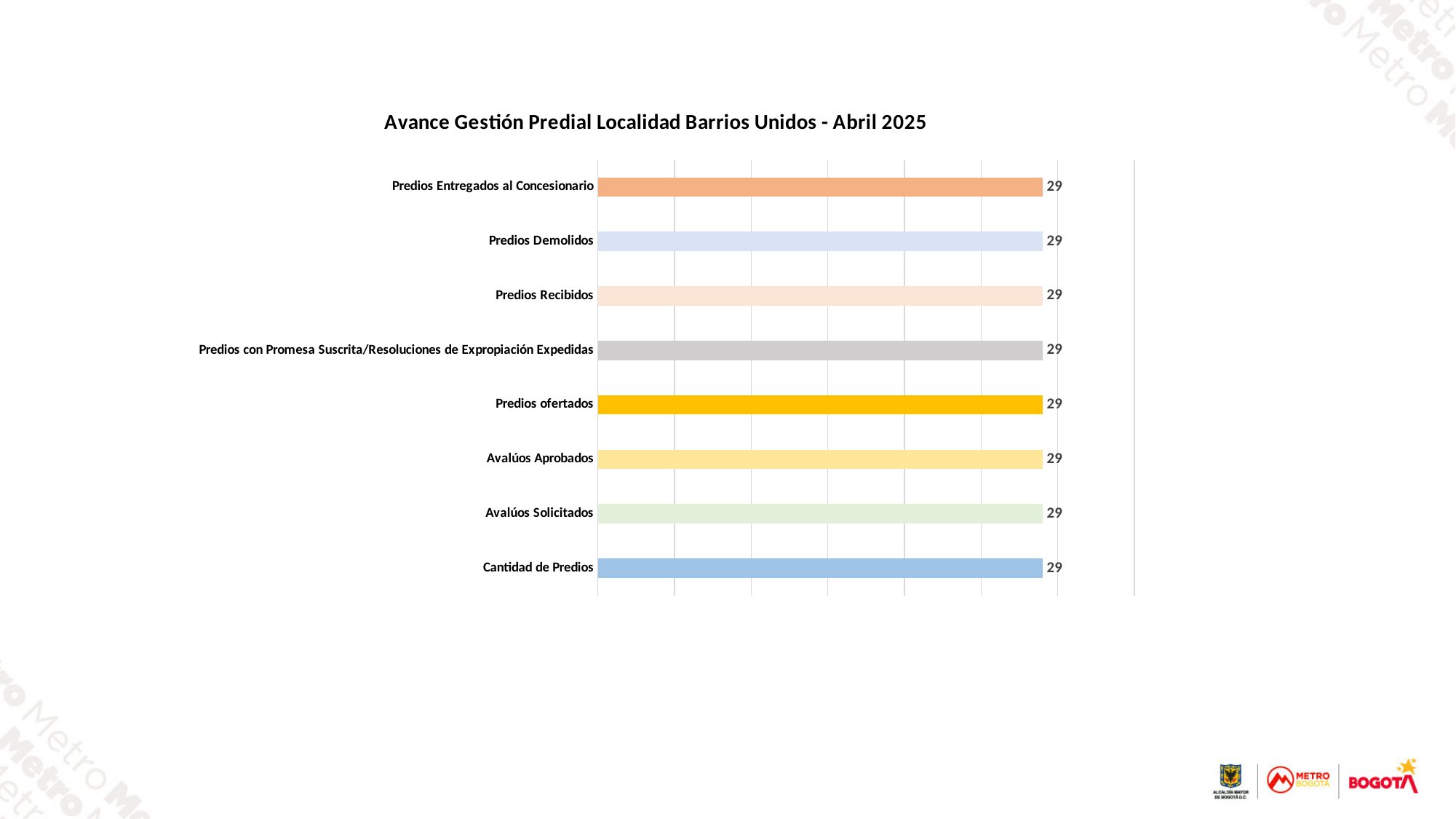
What is the value for Predios con Promesa Suscrita/Resoluciones de Expropiación Expedidas? 29 What is the title of the chart? Avance Gestión Predial Localidad Barrios Unidos - Abril 2025 What is the value for Cantidad de Predios? 29 What kind of chart is shown on the slide? Bar chart How many categories are shown in the chart? 8 What is the value for Avalúos Solicitados? 29 What is the value for Predios Demolidos? 29 Which category is drawn with the bright yellow-orange bar? Predios ofertados What is the difference between the values for Cantidad de Predios and Predios Recibidos? 0 What is the value for Predios Entregados al Concesionario? 29 Which is larger, the value for Avalúos Aprobados or the value for Predios Demolidos? They are equal (both 29) What is the value for Predios ofertados? 29